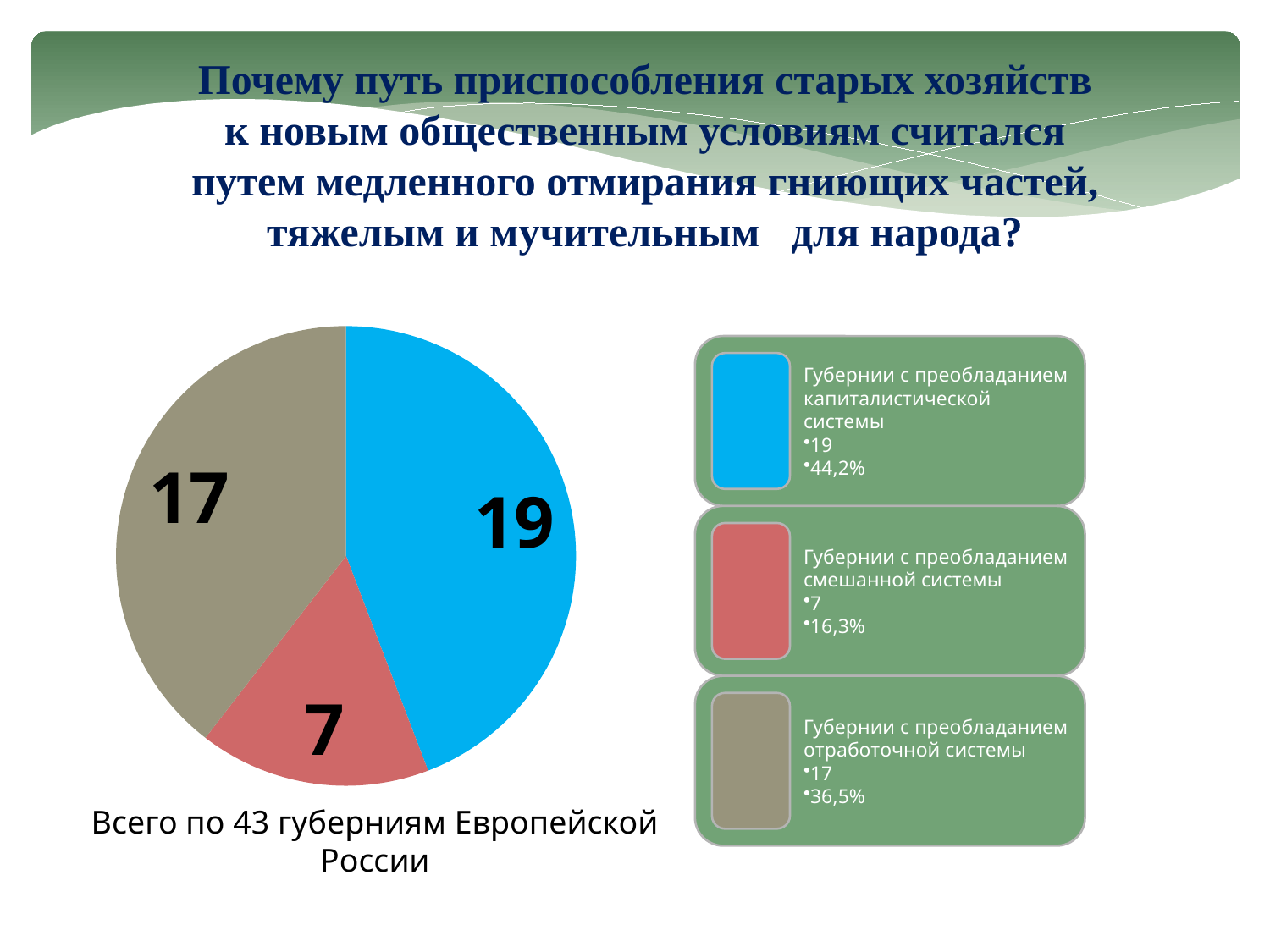
Which category has the largest slice of the pie? Губернии с преобладанием капиталистической системы What share of the pie does the смешанной system slice represent, according to the legend? 16,3% What kind of chart is shown on the slide? pie chart What value is shown for the slice representing губернии с преобладанием смешанной системы? 7 What value is shown for the slice representing губернии с преобладанием капиталистической системы? 19 Which category has the smallest slice of the pie? Губернии с преобладанием смешанной системы What is the difference between the values for the капиталистической and отработочной system slices? 2 How many slices does the pie chart have? 3 Which is larger: the slice for the смешанной system or the slice for the отработочной system? отработочной системы What share of the pie does the капиталистической system slice represent, according to the legend? 44,2% What colour is the slice for губернии с преобладанием отработочной системы? olive grey What value is shown for the slice representing губернии с преобладанием отработочной системы? 17